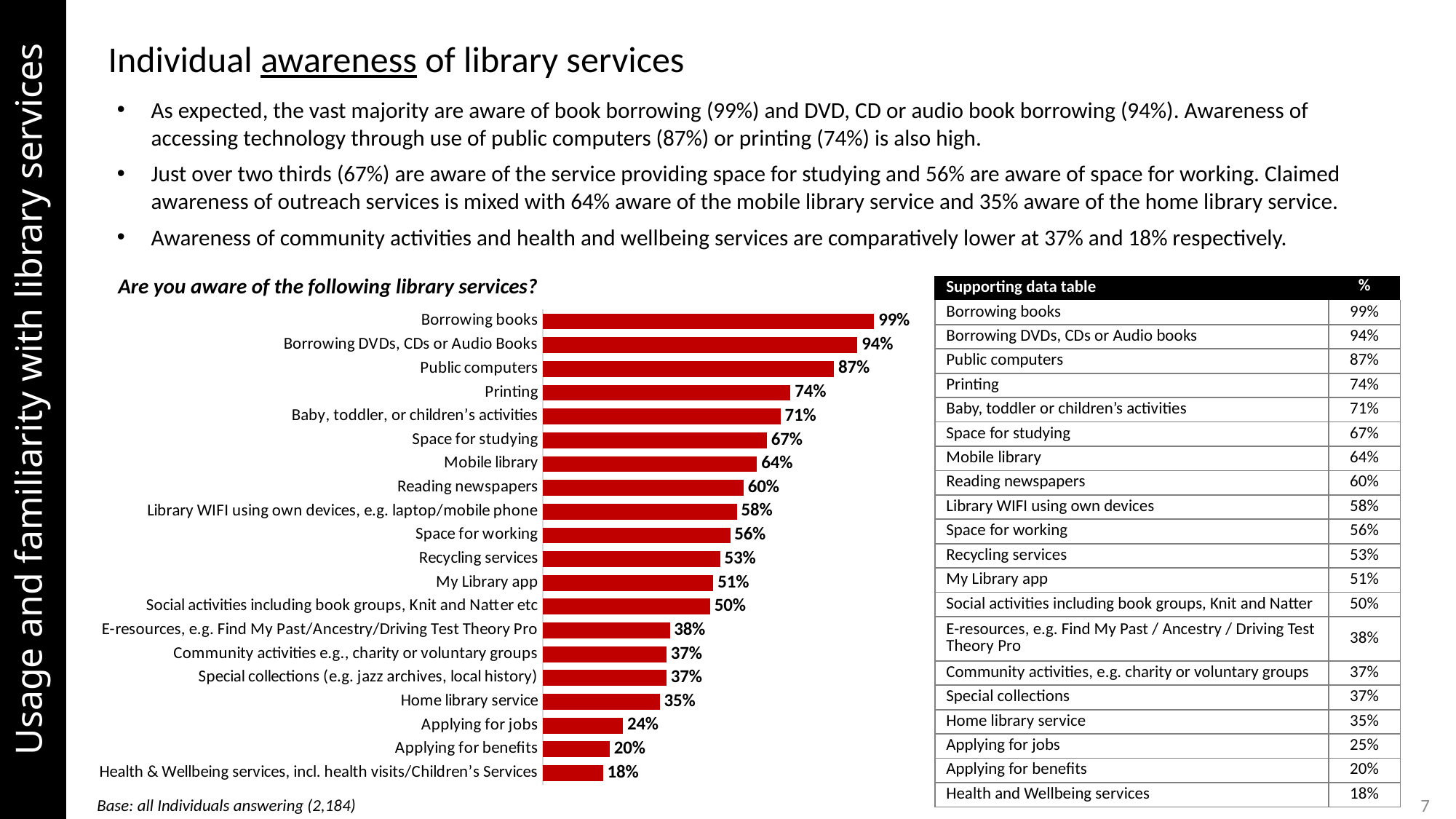
Which has higher awareness: Space for studying or Space for working? Space for studying What is the difference between awareness of Public computers and awareness of Printing? 13% What is the title of the chart? Are you aware of the following library services? Which library service has the highest awareness in the chart? Borrowing books What percentage are aware of Recycling services? 53% What type of chart is used to show awareness of library services? Bar chart What colour are the bars in the chart? Red What is the difference between awareness of Reading newspapers and awareness of Applying for benefits? 40% What is the value shown for Mobile library in the chart? 64% How many library services are listed in the chart? 20 What percentage of individuals are aware of borrowing books? 99% Which library service has the lowest awareness in the chart? Health & Wellbeing services, incl. health visits/Children's Services